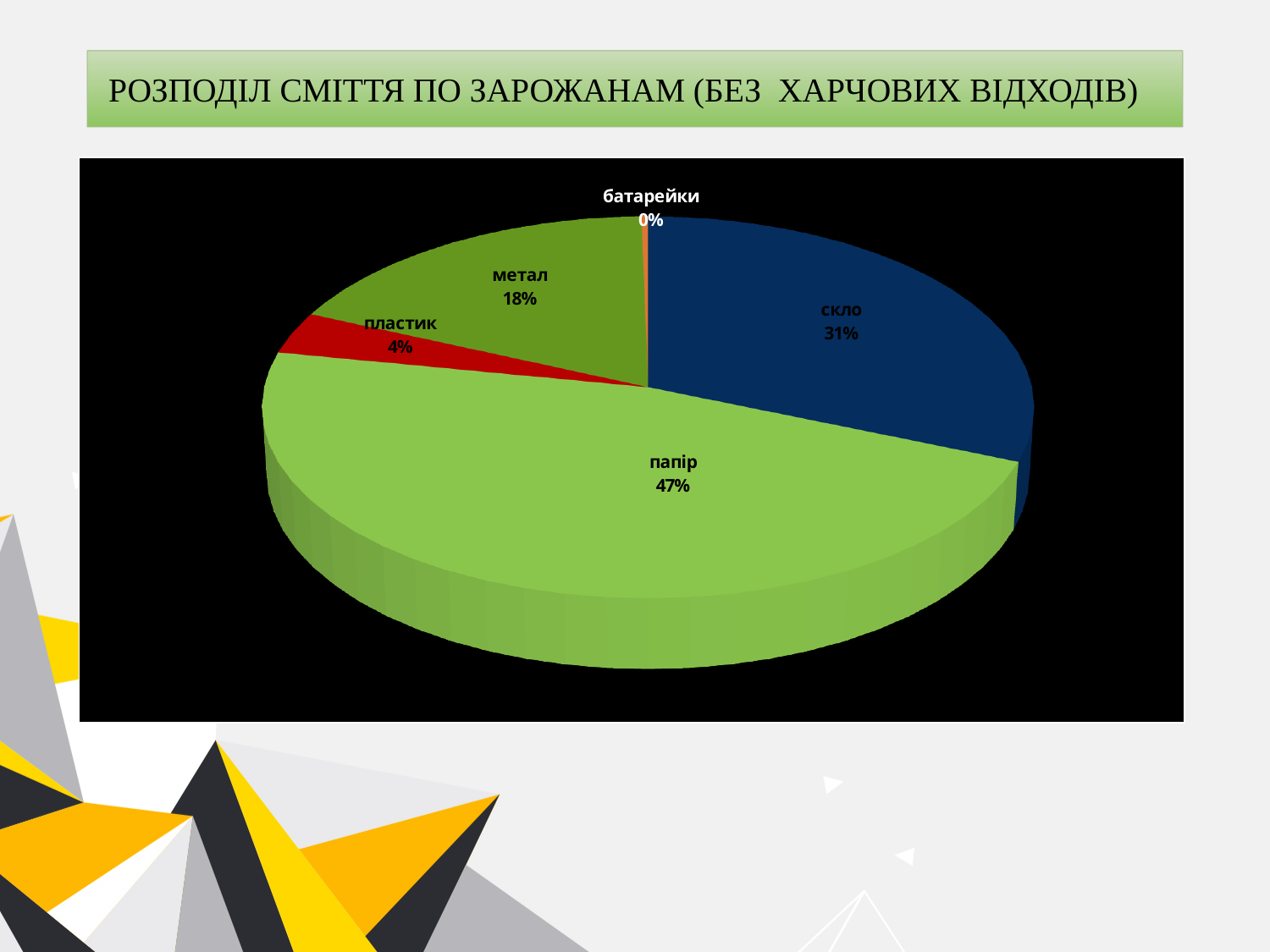
What is the difference in percentage points between папір and скло? 16 What share of the pie does скло have? 31% What is the title of the slide? РОЗПОДІЛ СМІТТЯ ПО ЗАРОЖАНАМ (БЕЗ ХАРЧОВИХ ВІДХОДІВ) Which category has the smallest slice of the pie? батарейки Which category has the largest slice of the pie? папір What type of chart is shown on the slide? pie chart What share of the pie does папір have? 47% What share of the pie does пластик have? 4% How many categories are shown in the pie chart? 5 Which is larger, the share for метал or the share for пластик? метал